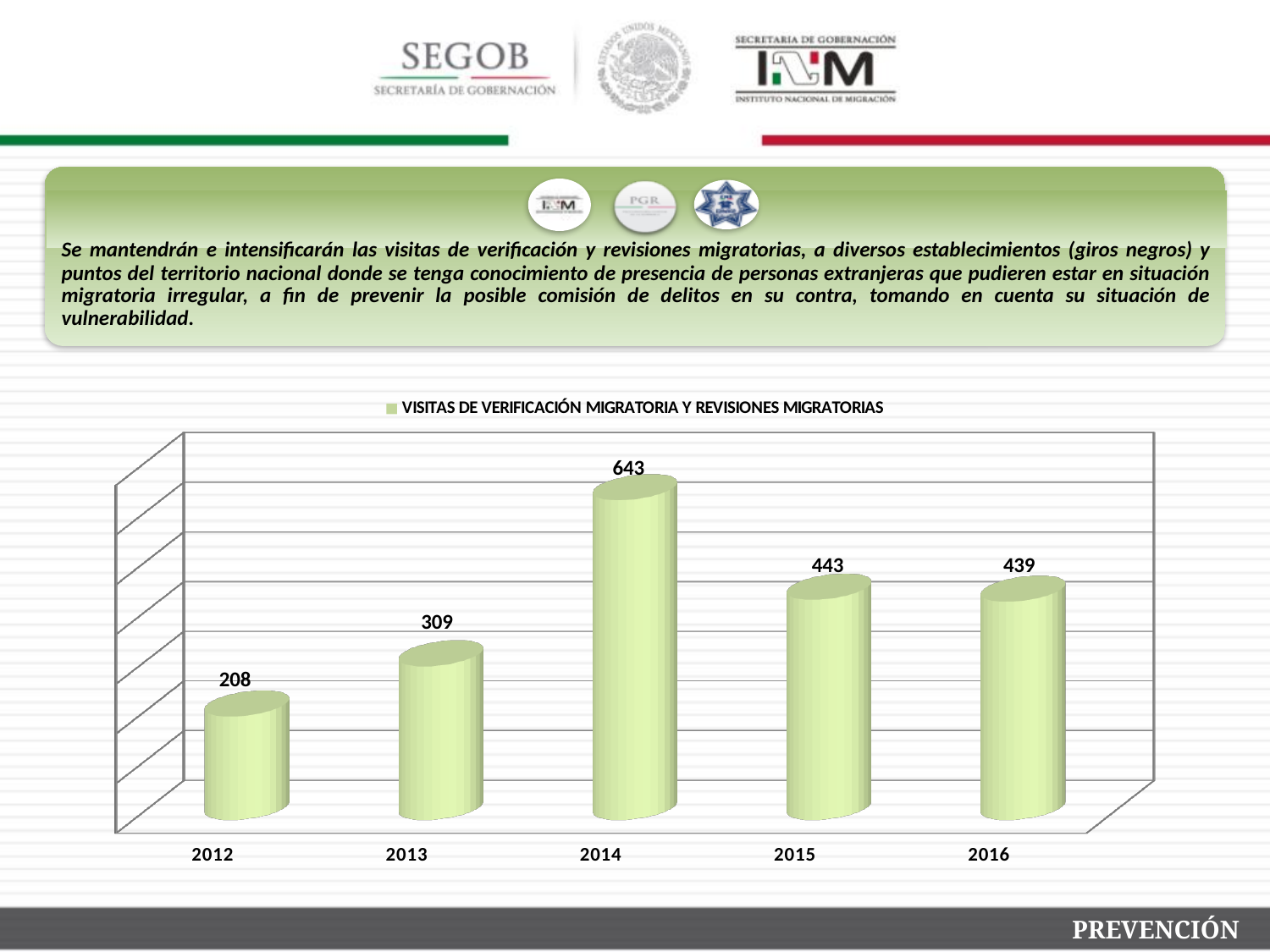
What is the difference between the values for 2015 and 2016? 4 What is the value for 2014? 643 Which is larger, the value for 2013 or the value for 2015? 2015 What kind of chart is shown? bar chart How many years are shown on the x axis? 5 What is the value for 2016? 439 What is the value for 2012? 208 Which year has the lowest value? 2012 Which year has the highest value? 2014 What is the difference between the values for 2014 and 2013? 334 What is the legend entry for the series? VISITAS DE VERIFICACIÓN MIGRATORIA Y REVISIONES MIGRATORIAS How many series does the legend list? 1